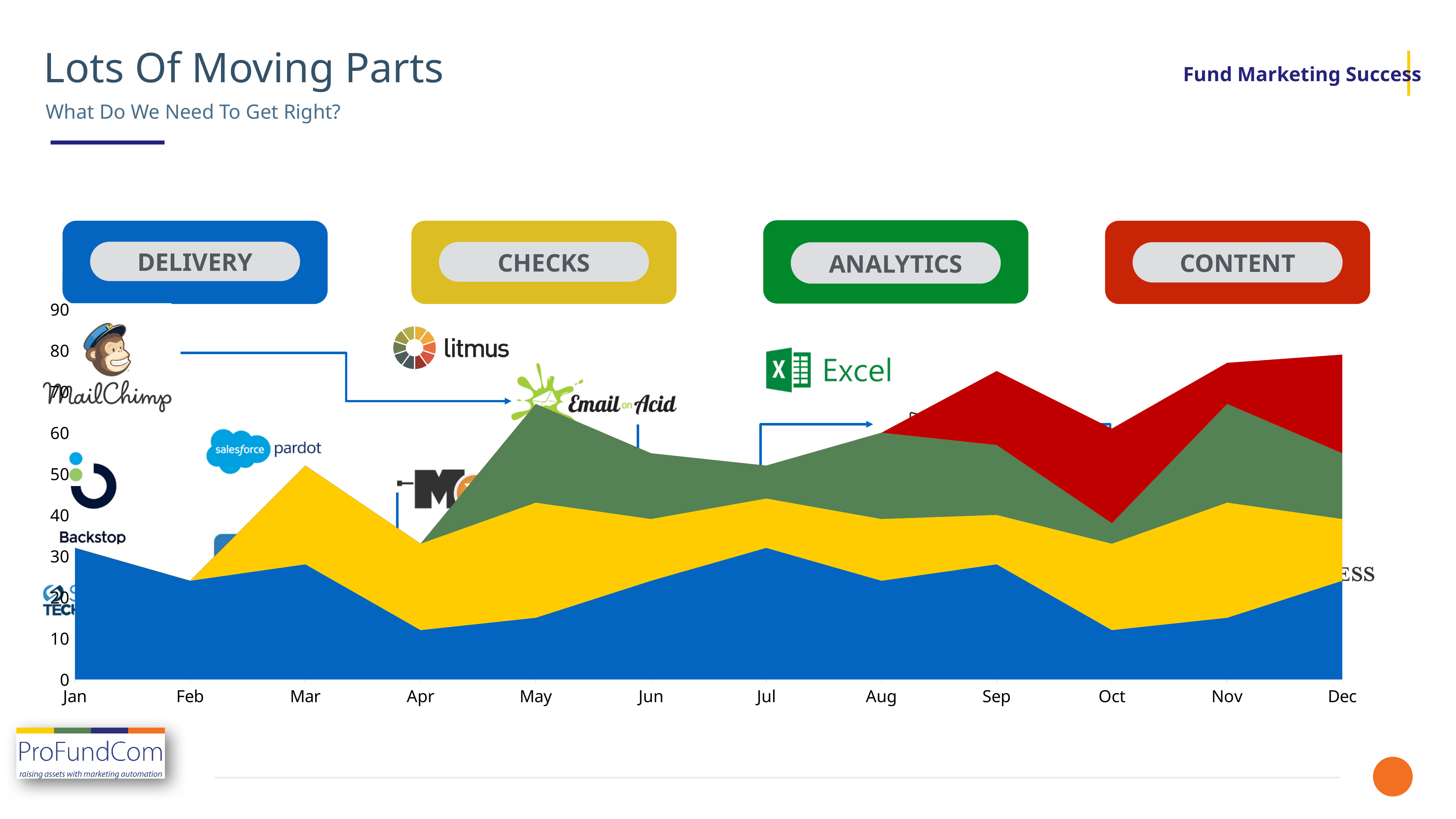
Is the total stacked height in Dec greater or less than 70? greater Is the value of the blue (bottom) series in Oct greater or less than 20? less How many coloured series are stacked in the chart? 4 What kind of chart is shown on the slide? stacked area chart Which colour is the bottom series of the stacked chart? blue Is the value of the blue (bottom) series in Jul greater or less than 20? greater Which label appears in the red box above the chart? CONTENT Does the blue (bottom) series rise or fall from Apr to Jul? rise Which is larger: the blue series value in Apr or in Jul? Jul How many months are shown along the x axis of the chart? 12